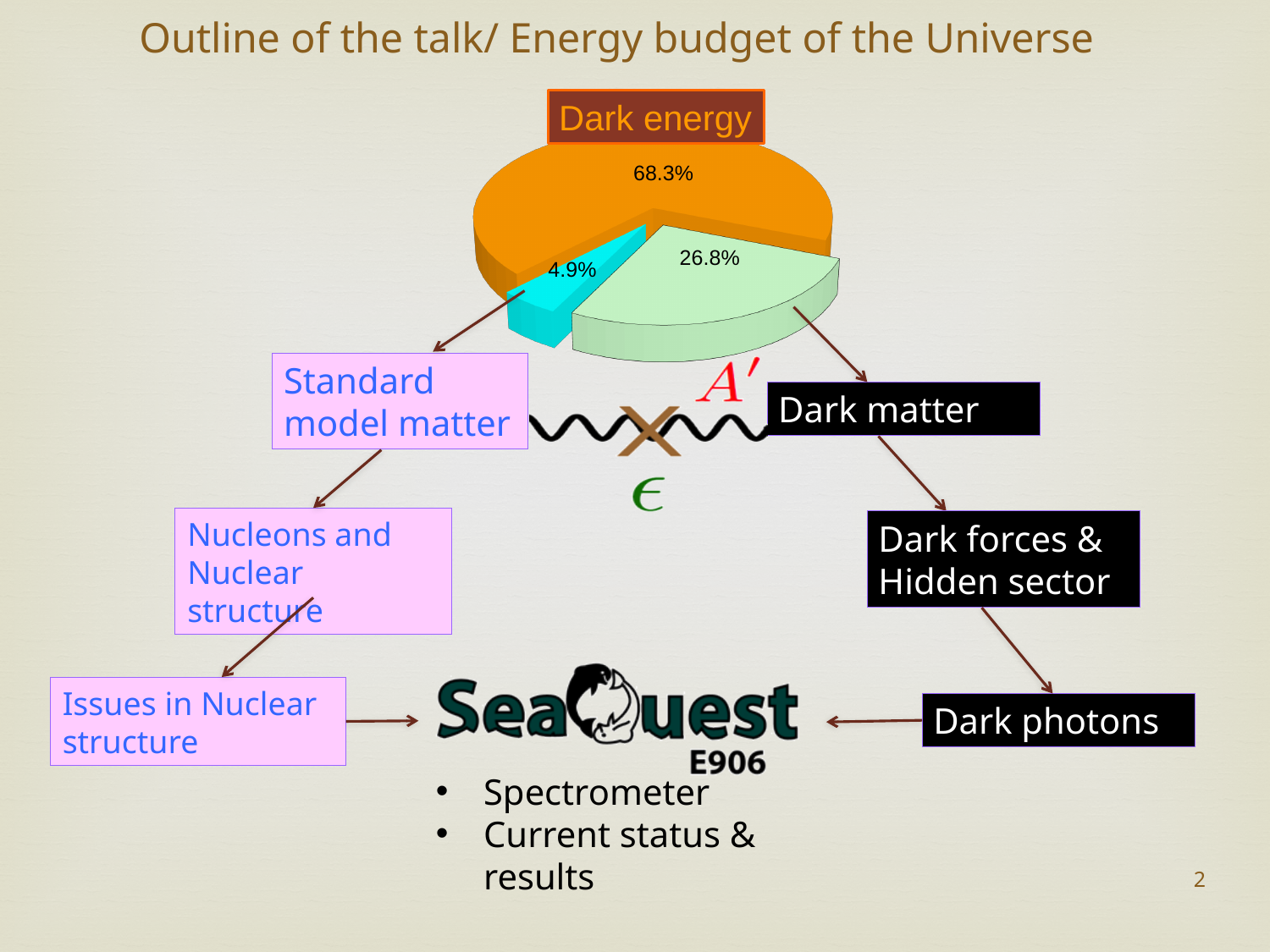
Which slice of the pie chart is the largest? Dark energy (68.3%) What colour is the Dark energy slice of the pie chart? orange Is the Dark energy share of the pie greater or less than 50%? greater What percentage is shown on the green slice of the pie chart? 26.8% What kind of chart is shown on the slide? pie chart What percentage is shown for the Dark energy slice of the pie chart? 68.3% How many slices does the pie chart have? 3 What is the difference between the green slice (26.8%) and the cyan slice (4.9%)? 21.9% Which is larger, the green slice or the cyan slice of the pie chart? the green slice (26.8%) What percentage is shown on the cyan slice of the pie chart? 4.9% What is the value of the smallest slice of the pie chart? 4.9% What is the difference between the Dark energy slice (68.3%) and the green slice (26.8%)? 41.5%